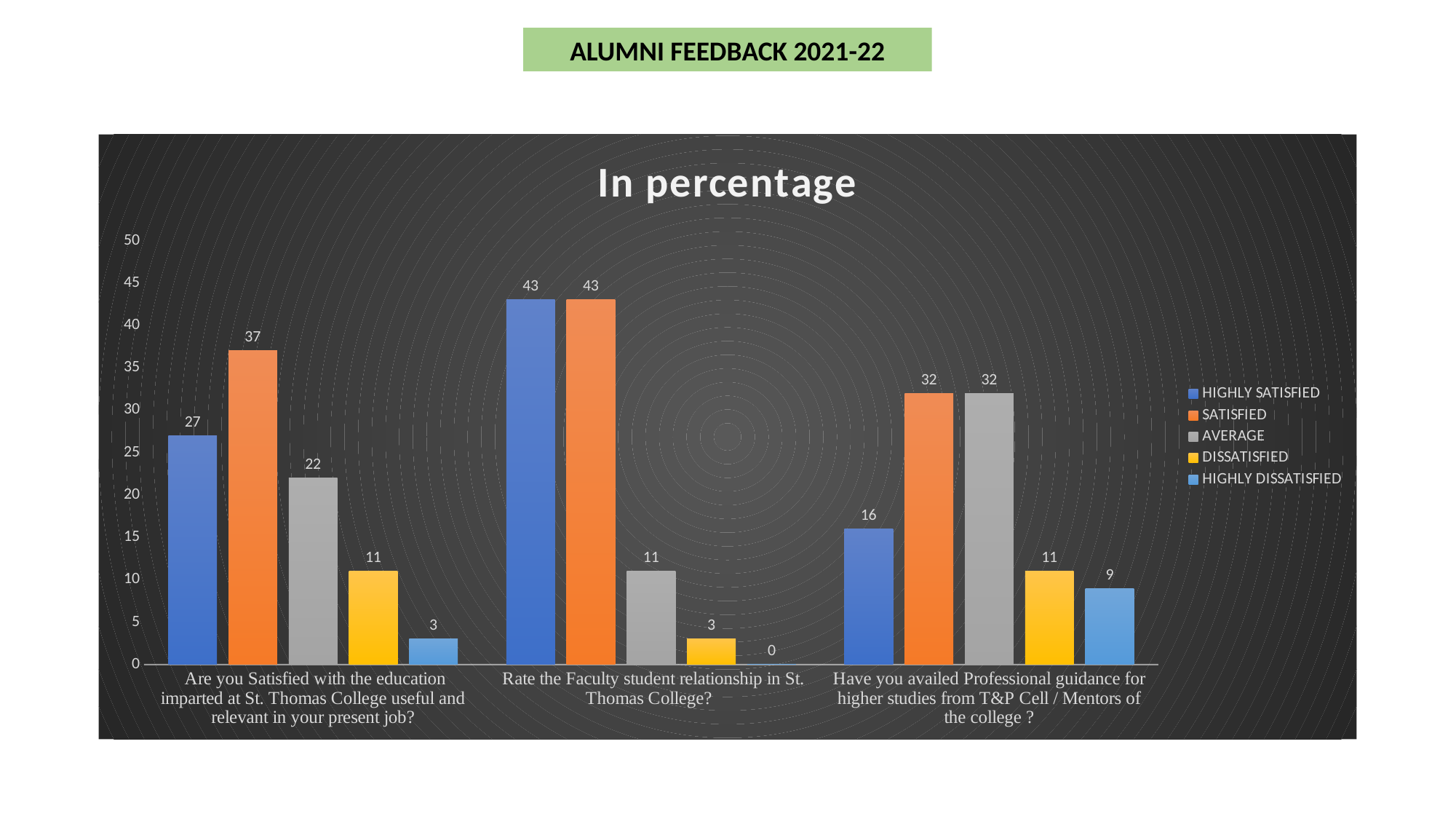
What is the value for AVERAGE for the question "Rate the Faculty student relationship in St. Thomas College?"? 11 What is the title of the chart? In percentage What is the value for HIGHLY DISSATISFIED for the question "Have you availed Professional guidance for higher studies from T&P Cell / Mentors of the college ?"? 9 Which series has the lowest value for the question "Have you availed Professional guidance for higher studies from T&P Cell / Mentors of the college ?"? HIGHLY DISSATISFIED What kind of chart is shown on the slide? Bar chart How many series does the legend list? 5 What is the value for HIGHLY SATISFIED for the question "Are you Satisfied with the education imparted at St. Thomas College useful and relevant in your present job?"? 27 How many question categories are shown on the x axis? 3 Which is larger: the AVERAGE value for the education question or the AVERAGE value for the faculty student relationship question? The education question What is the difference between the SATISFIED and HIGHLY SATISFIED values for the question "Have you availed Professional guidance for higher studies from T&P Cell / Mentors of the college ?"? 16 Which series has the highest value for the question "Are you Satisfied with the education imparted at St. Thomas College useful and relevant in your present job?"? SATISFIED What is the value for HIGHLY DISSATISFIED for the question "Rate the Faculty student relationship in St. Thomas College?"? 0